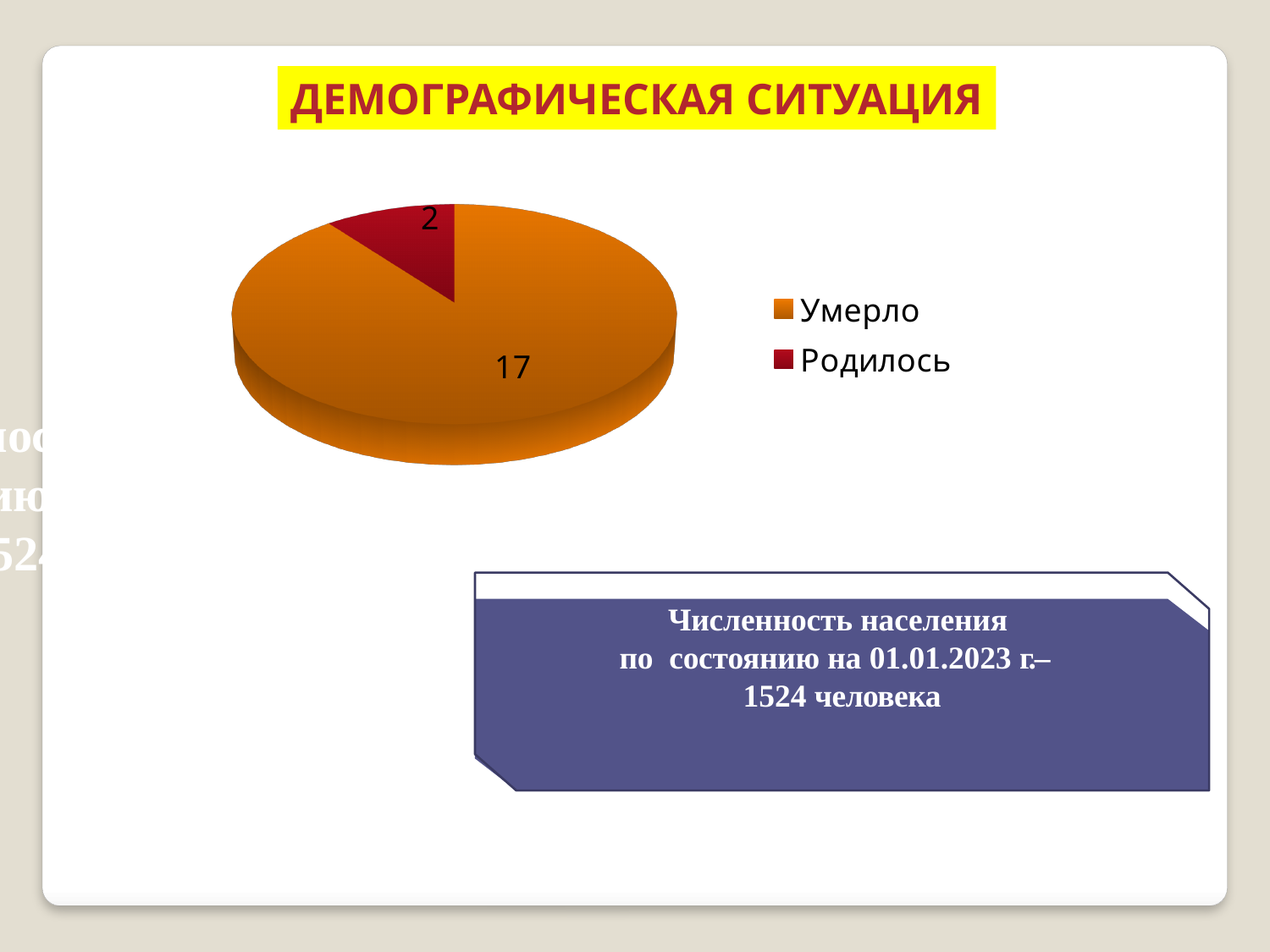
What kind of chart is shown on the slide? pie chart What is the title shown above the chart? ДЕМОГРАФИЧЕСКАЯ СИТУАЦИЯ Which category has the smallest slice? Родилось What is the total of the two slices? 19 What is the value for Родилось? 2 What is the value for Умерло? 17 What is the difference between the values for Умерло and Родилось? 15 Which is larger, Умерло or Родилось? Умерло How many entries does the legend list? 2 Which category has the largest slice? Умерло What colour is the Родилось slice? dark red How many slices does the pie chart have? 2